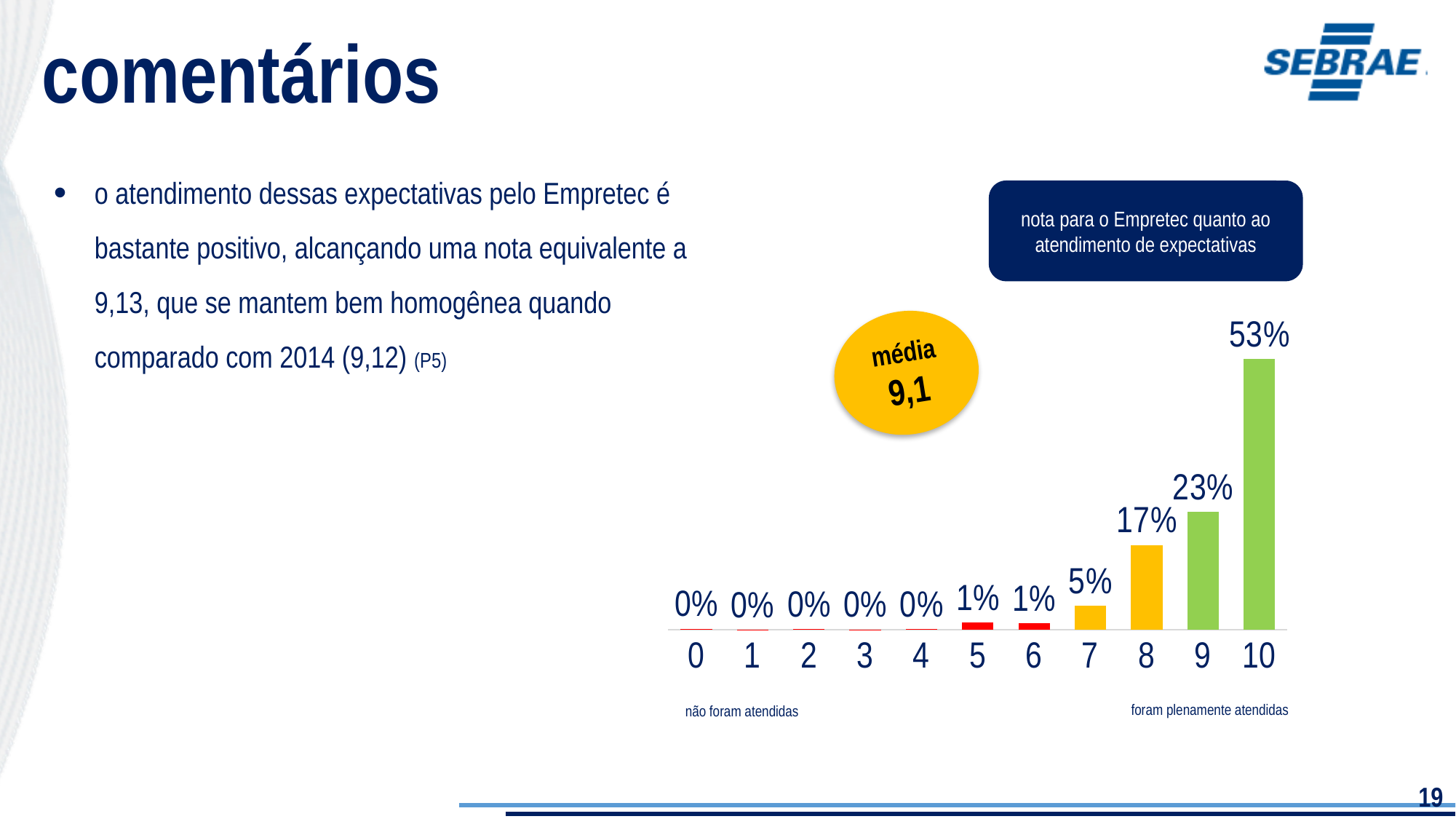
What percentage of respondents gave a score of 10? 53% What average (média) is shown in the yellow circle next to the chart? 9,1 How many score categories are shown on the x axis? 11 What is the difference between the percentages for scores 10 and 9? 30% Which has a larger value, score 8 or score 9? 9 What is the value shown for score 8? 17% What is the value shown for score 5? 1% What is the difference between the percentages for scores 9 and 8? 6% What is the value shown for score 7? 5% What kind of chart is shown on the slide? bar chart Which score has the highest percentage? 10 Do the values generally rise or fall as the score increases from 0 to 10? rise